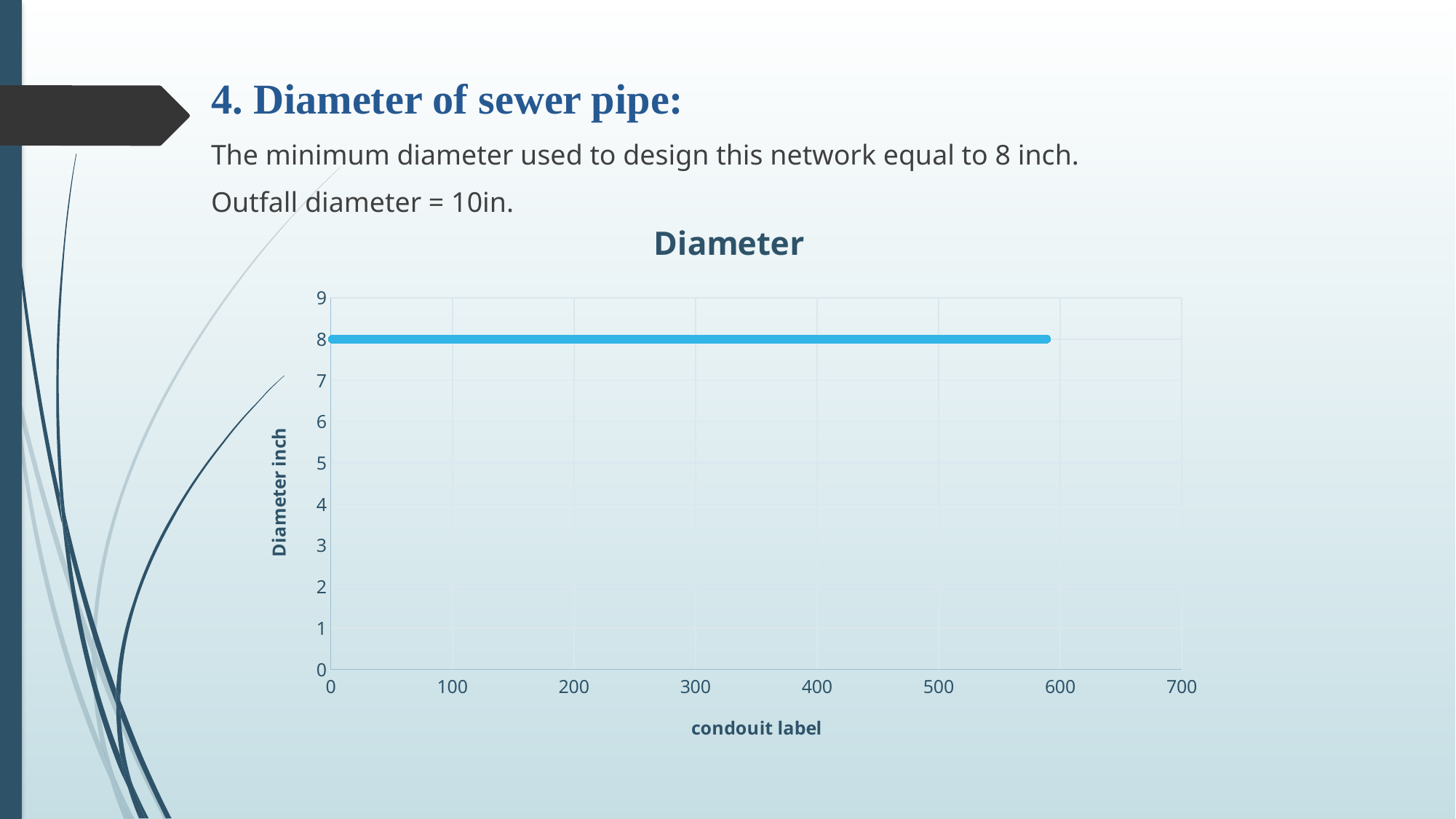
Is the diameter value at conduit label 500 greater or less than 9? less What diameter value does the plotted line sit at across the conduit labels? 8 What is the diameter value at conduit label 300? 8 What is the y-axis title of the chart? Diameter inch What is the minimum diameter value plotted on the chart? 8 Is the diameter value at conduit label 200 greater or less than 5? greater What is the title of the chart? Diameter Do the diameter values rise, fall, or stay constant as the conduit label increases? stay constant What is the maximum diameter value plotted on the chart? 8 What is the highest tick value shown on the y-axis? 9 Does the plotted line extend past conduit label 600? No